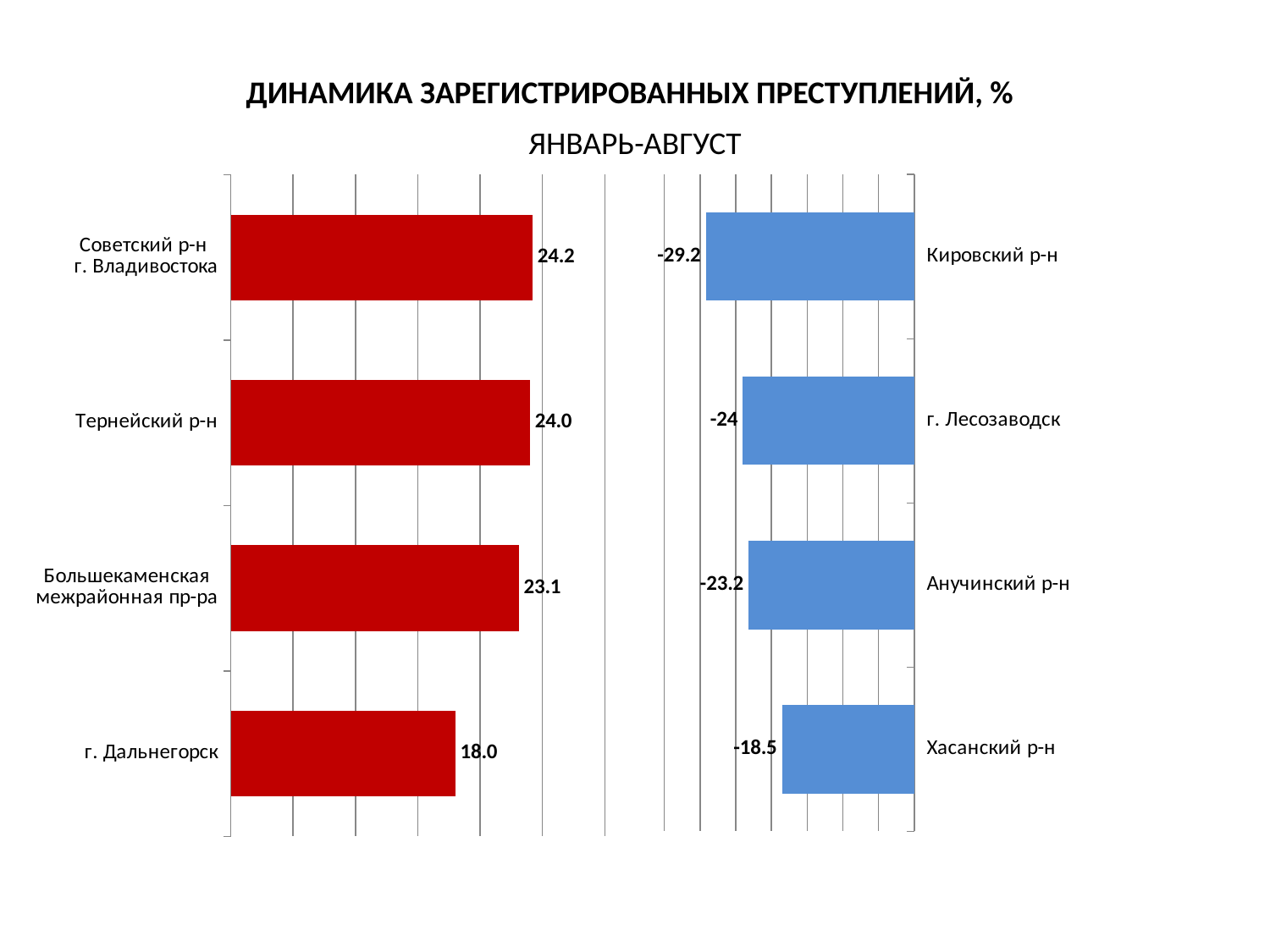
On the left (red) chart, which category has the lowest value? г. Дальнегорск On the right (blue) chart, which category has the lowest value? Кировский р-н On the left (red) chart, which category has the highest value? Советский р-н г. Владивостока How many categories are shown on the right (blue) chart? 4 What type of chart is used on this slide? Bar chart On the right (blue) chart, what is the value for Кировский р-н? -29.2 On the right (blue) chart, what is the difference between the values for г. Лесозаводск and Анучинский р-н? 0.8 On the left (red) chart, what is the difference between the values for Советский р-н г. Владивостока and г. Дальнегорск? 6.2 On the left (red) chart, what is the value for г. Дальнегорск? 18.0 On the left (red) chart, which is larger: the value for Большекаменская межрайонная пр-ра or г. Дальнегорск? Большекаменская межрайонная пр-ра On the left (red) chart, what is the value for Тернейский р-н? 24.0 On the right (blue) chart, what is the value for Хасанский р-н? -18.5